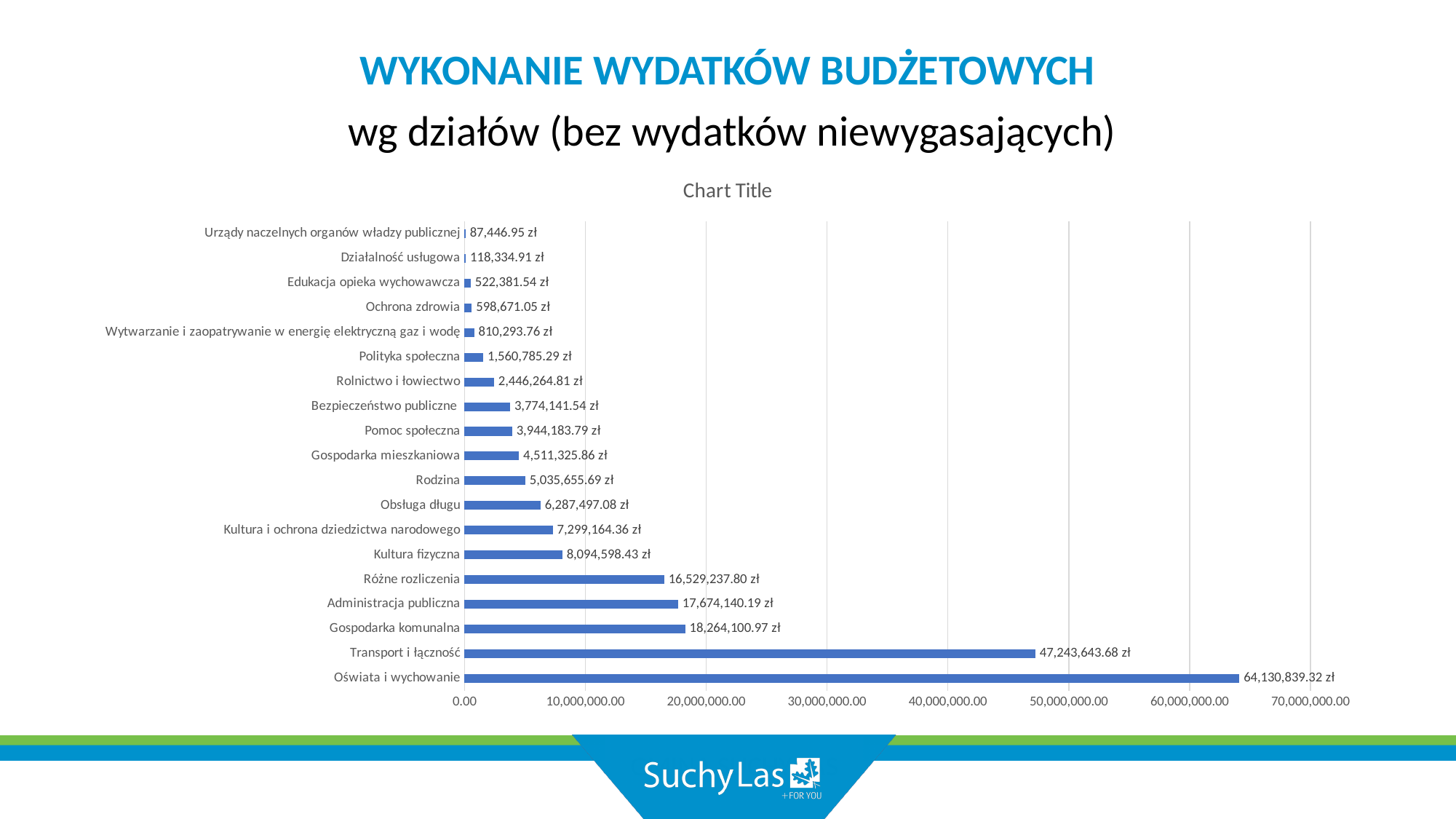
What is the value for Rolnictwo i łowiectwo? 2,446,264.81 zł What is the difference between the values for Oświata i wychowanie and Transport i łączność? 16,887,195.64 zł What is the value for Gospodarka komunalna? 18,264,100.97 zł Is the value for Różne rozliczenia greater or less than 10,000,000.00? greater How many categories are shown in the chart? 19 Which category has the lowest value? Urządy naczelnych organów władzy publicznej Which category has the highest value? Oświata i wychowanie Which is larger, the value for Kultura fizyczna or the value for Obsługa długu? Kultura fizyczna What is the value for Transport i łączność? 47,243,643.68 zł What is the difference between the values for Gospodarka komunalna and Administracja publiczna? 589,960.78 zł What kind of chart is shown on the slide? bar chart What is the value for Oświata i wychowanie? 64,130,839.32 zł